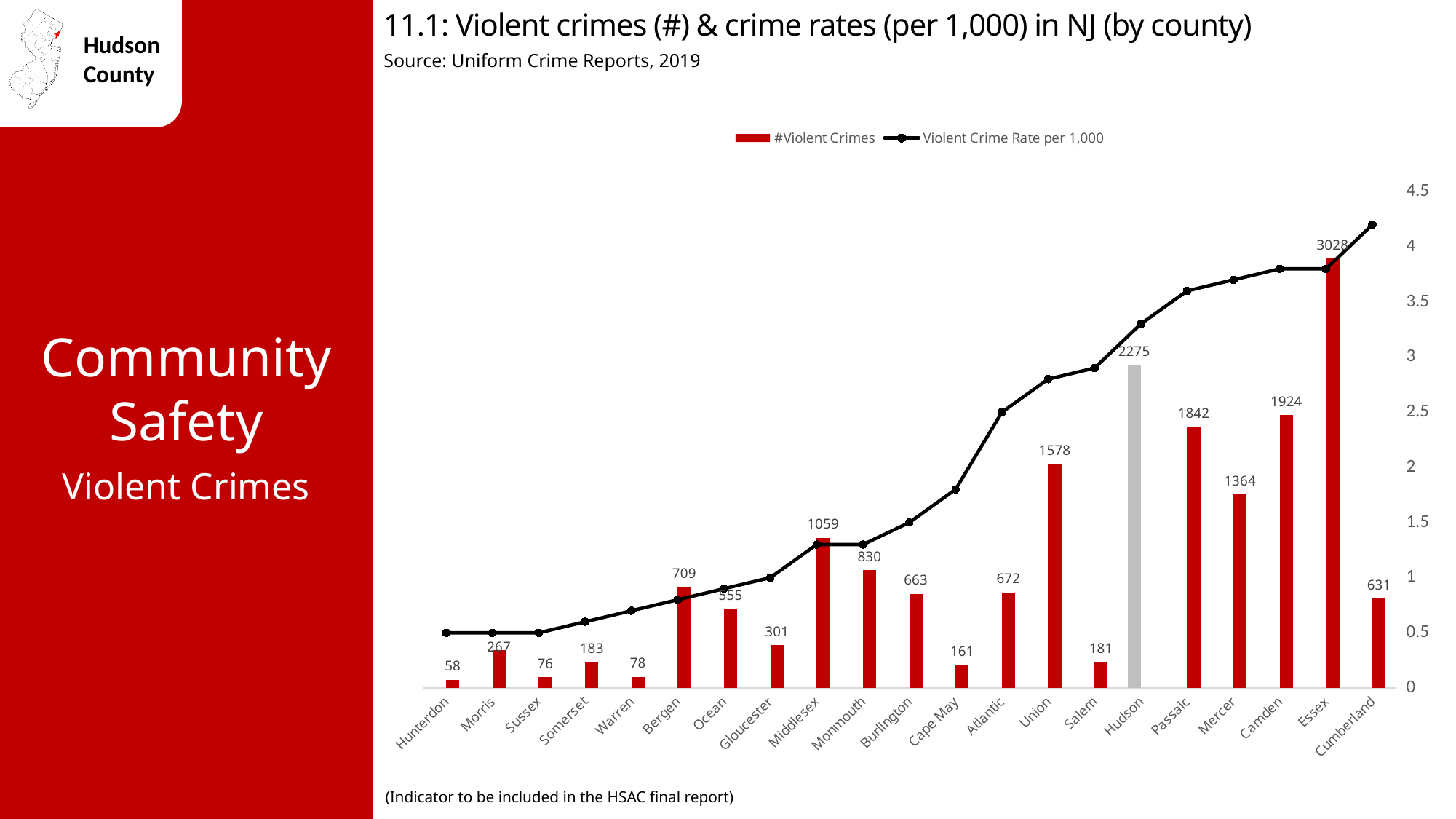
Does the Violent Crime Rate per 1,000 line generally rise or fall from Hunterdon to Cumberland? Rise Which has more violent crimes, Passaic or Camden? Camden Which county has the highest number of violent crimes? Essex Which county has the lowest number of violent crimes? Hunterdon How many violent crimes are shown for Middlesex? 1059 What is the difference in the number of violent crimes between Essex and Hudson? 753 How many series does the legend list? 2 How many counties are shown on the x axis? 21 How many violent crimes are shown for Hudson County? 2275 Is the violent crime rate per 1,000 for Hunterdon greater or less than 1? less Is the violent crime rate per 1,000 for Cumberland greater or less than 4? greater What kind of chart is used to show the #Violent Crimes series? Bar chart